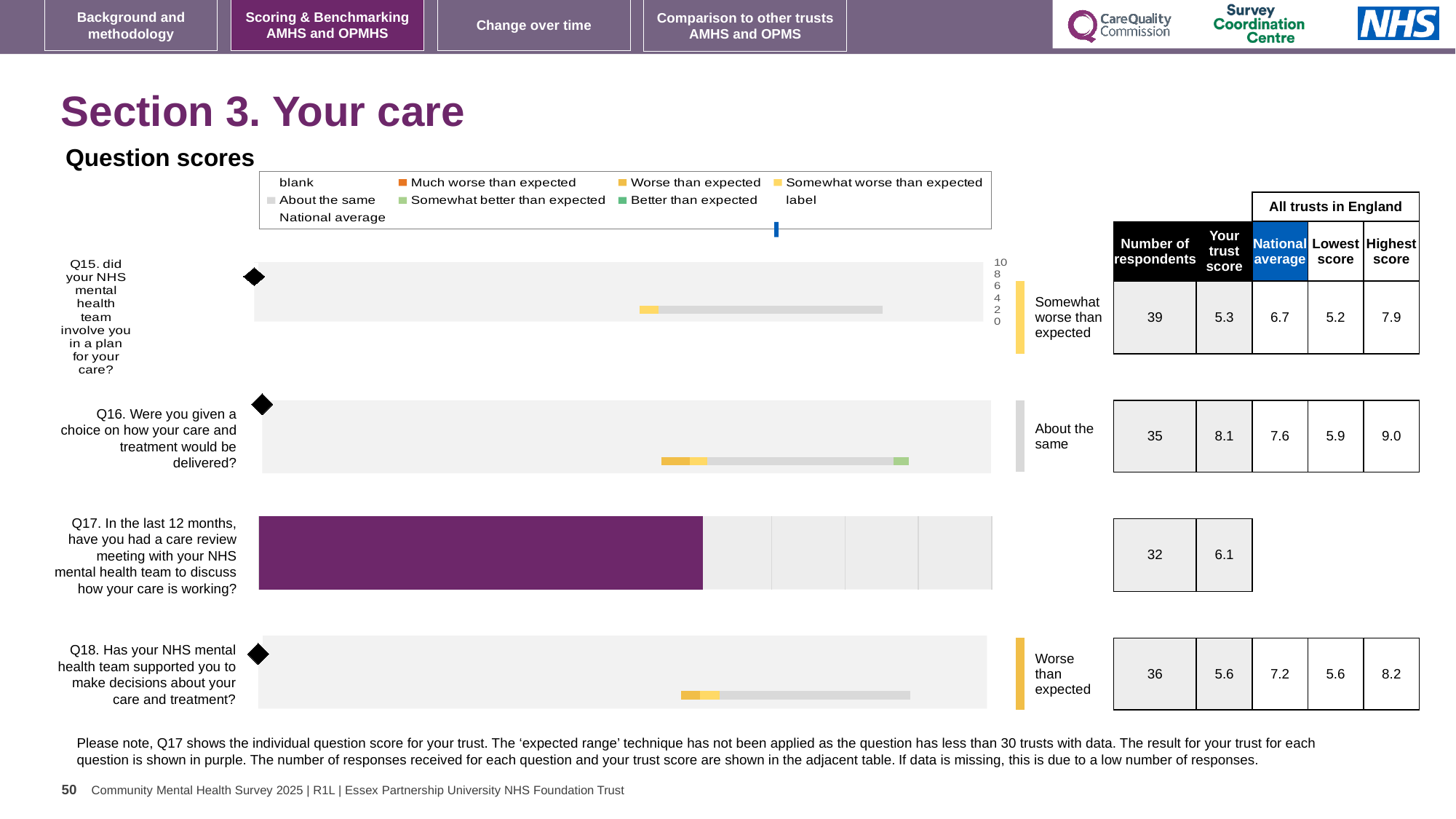
What is the highest score among all trusts in England for Q16? 9.0 What kind of chart is used to show the question scores? Bar chart By how much does the trust score for Q16 exceed the national average for Q16? 0.5 How many questions are plotted in the Question scores chart? 4 For Q15, which is larger: the trust score or the national average? National average What is the lowest score among all trusts in England for Q15? 5.2 What is the trust score for Q16 (Were you given a choice on how your care and treatment would be delivered)? 8.1 Which question has the highest trust score on this slide? Q16 What is the national average score for Q18 (Has your NHS mental health team supported you to make decisions about your care and treatment)? 7.2 Which question has the lowest trust score on this slide? Q15 How many respondents answered Q15 (did your NHS mental health team involve you in a plan for your care)? 39 What benchmark category label is shown next to the bar for Q18? Worse than expected